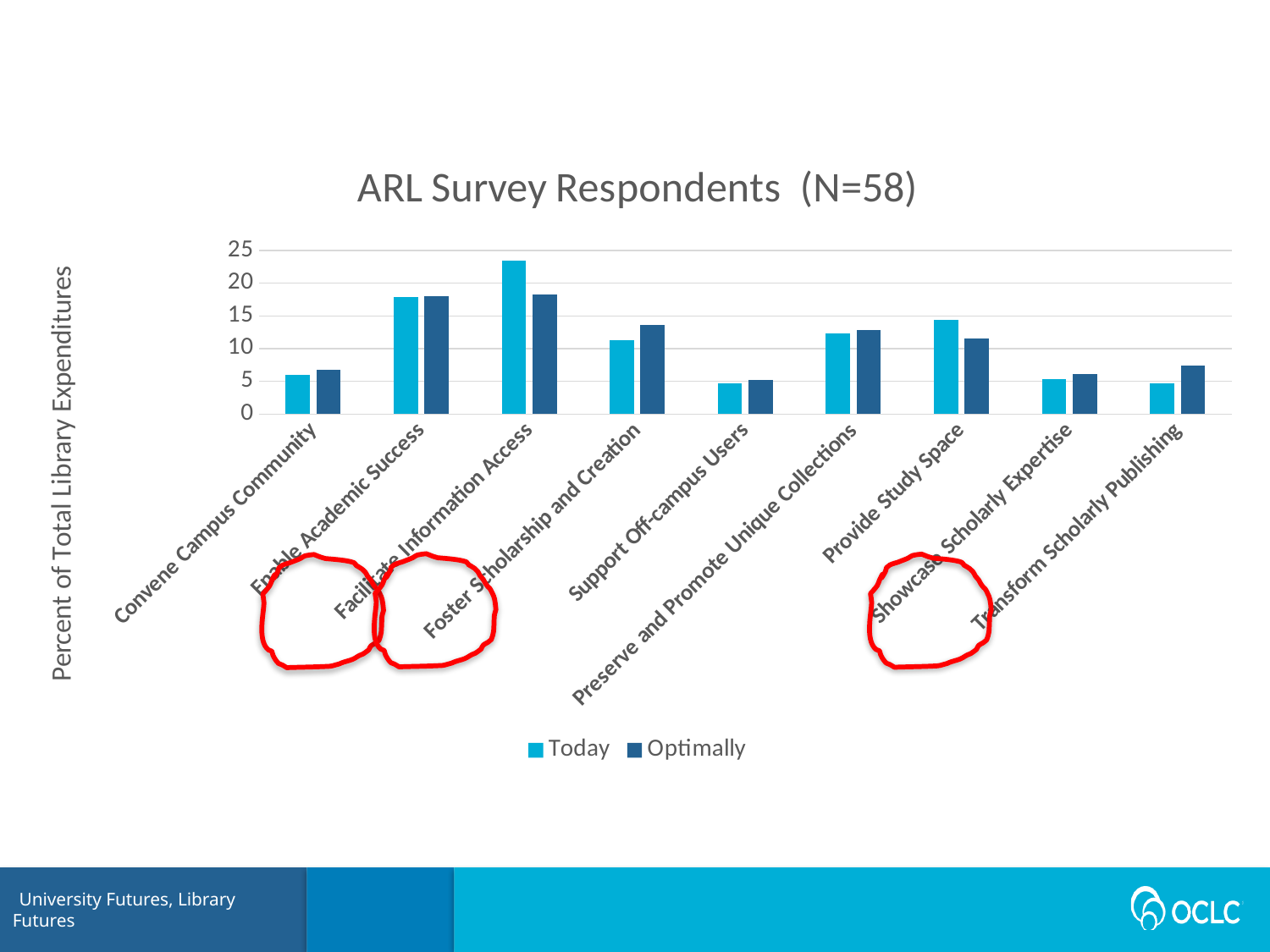
Is the Today value for Facilitate Information Access greater or less than 20? greater What kind of chart is shown on the slide? Bar chart How many series does the legend list? 2 Is the Optimally value for Transform Scholarly Publishing greater or less than 5? greater Is the Today value for Provide Study Space greater or less than 10? greater How many categories are shown on the x axis? 9 For Facilitate Information Access, which is larger: the Today value or the Optimally value? Today What is the title of the chart? ARL Survey Respondents (N=58) What is the label on the vertical axis? Percent of Total Library Expenditures Which category has the highest Today value? Facilitate Information Access For Transform Scholarly Publishing, which is larger: the Today value or the Optimally value? Optimally